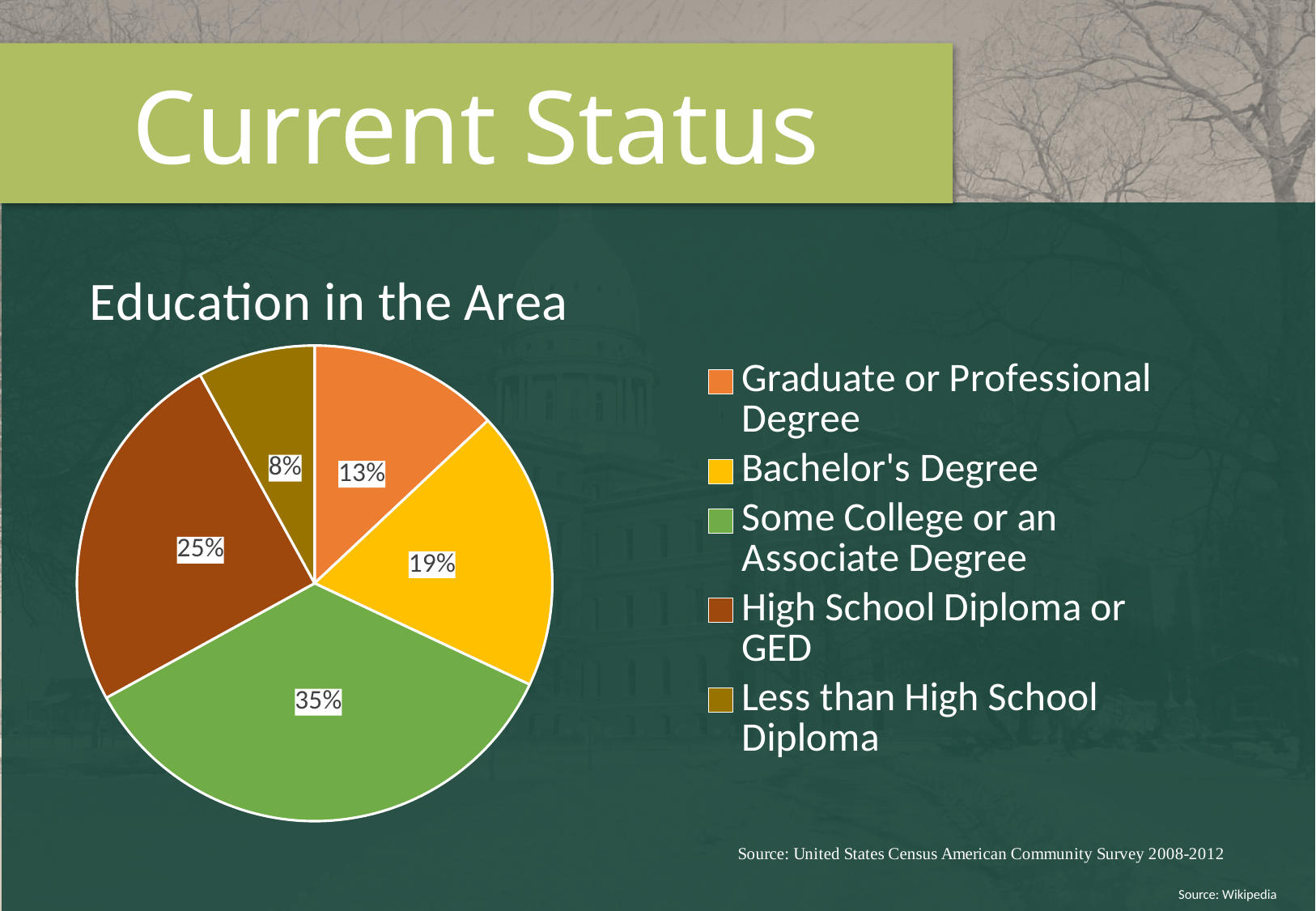
What is the title of the chart? Education in the Area Which category has the largest slice of the pie? Some College or an Associate Degree Which is larger, Bachelor's Degree or Graduate or Professional Degree? Bachelor's Degree What share of the pie is Less than High School Diploma? 8% What share of the pie is Some College or an Associate Degree? 35% What share of the pie is Graduate or Professional Degree? 13% What is the difference in percentage points between Some College or an Associate Degree and High School Diploma or GED? 10 What share of the pie is High School Diploma or GED? 25% How many categories does the legend list? 5 What type of chart is shown on the slide? pie chart Which category has the smallest slice of the pie? Less than High School Diploma What share of the pie is Bachelor's Degree? 19%